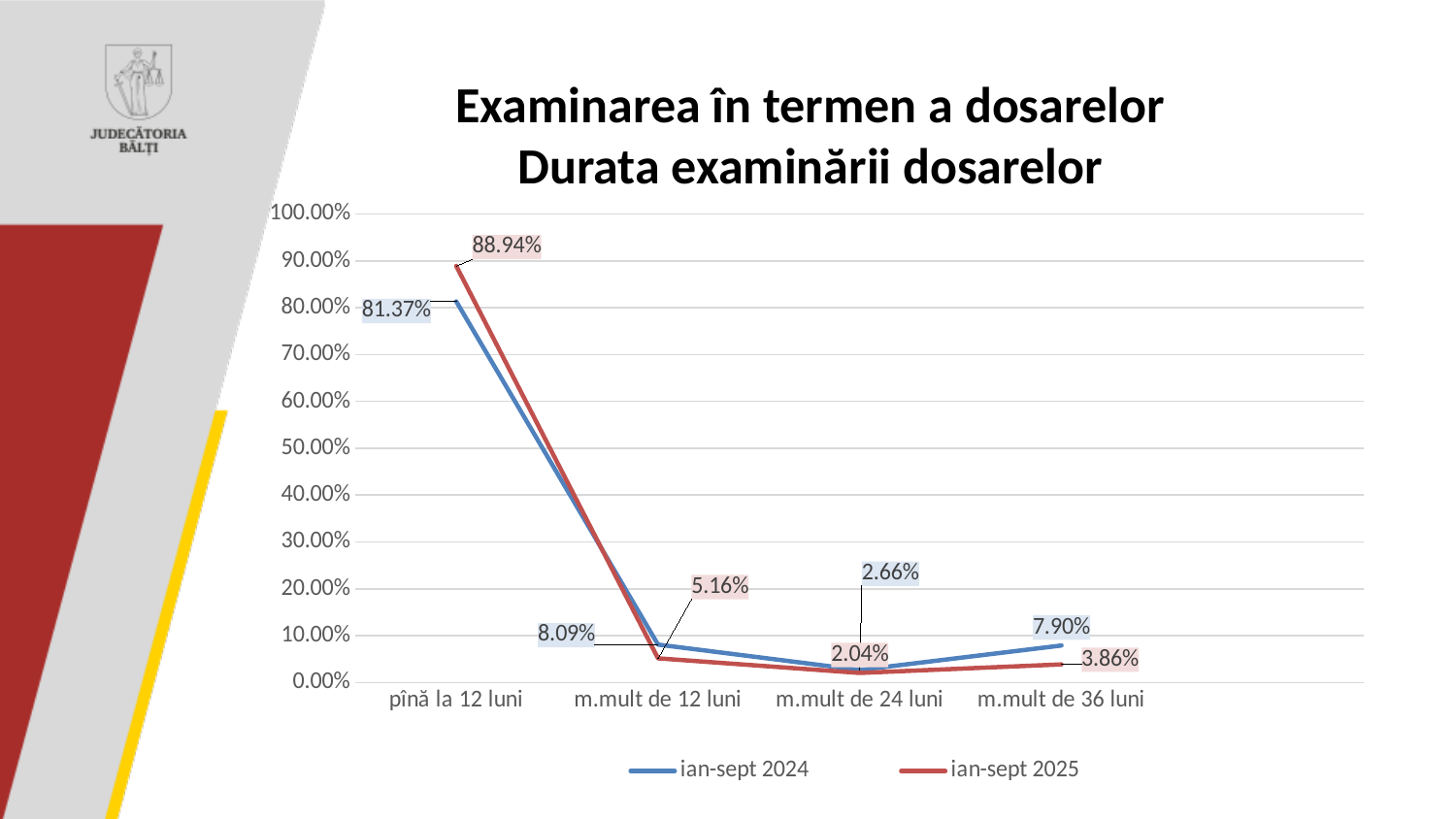
Which category has the lowest value in the ian-sept 2025 series? m.mult de 24 luni How many categories are shown on the x axis? 4 For 'm.mult de 36 luni', which series has the larger value, ian-sept 2024 or ian-sept 2025? ian-sept 2024 What type of chart is shown on the slide? line chart What is the difference between the ian-sept 2025 and ian-sept 2024 values for 'pînă la 12 luni'? 7.57% What is the value for 'm.mult de 24 luni' in the ian-sept 2025 series? 2.04% What is the value for 'm.mult de 36 luni' in the ian-sept 2024 series? 7.90% Which category has the highest value in the ian-sept 2024 series? pînă la 12 luni How many series does the legend list? 2 What colour is the line for the ian-sept 2025 series? red What is the value for 'pînă la 12 luni' in the ian-sept 2024 series? 81.37% What is the value for 'pînă la 12 luni' in the ian-sept 2025 series? 88.94%